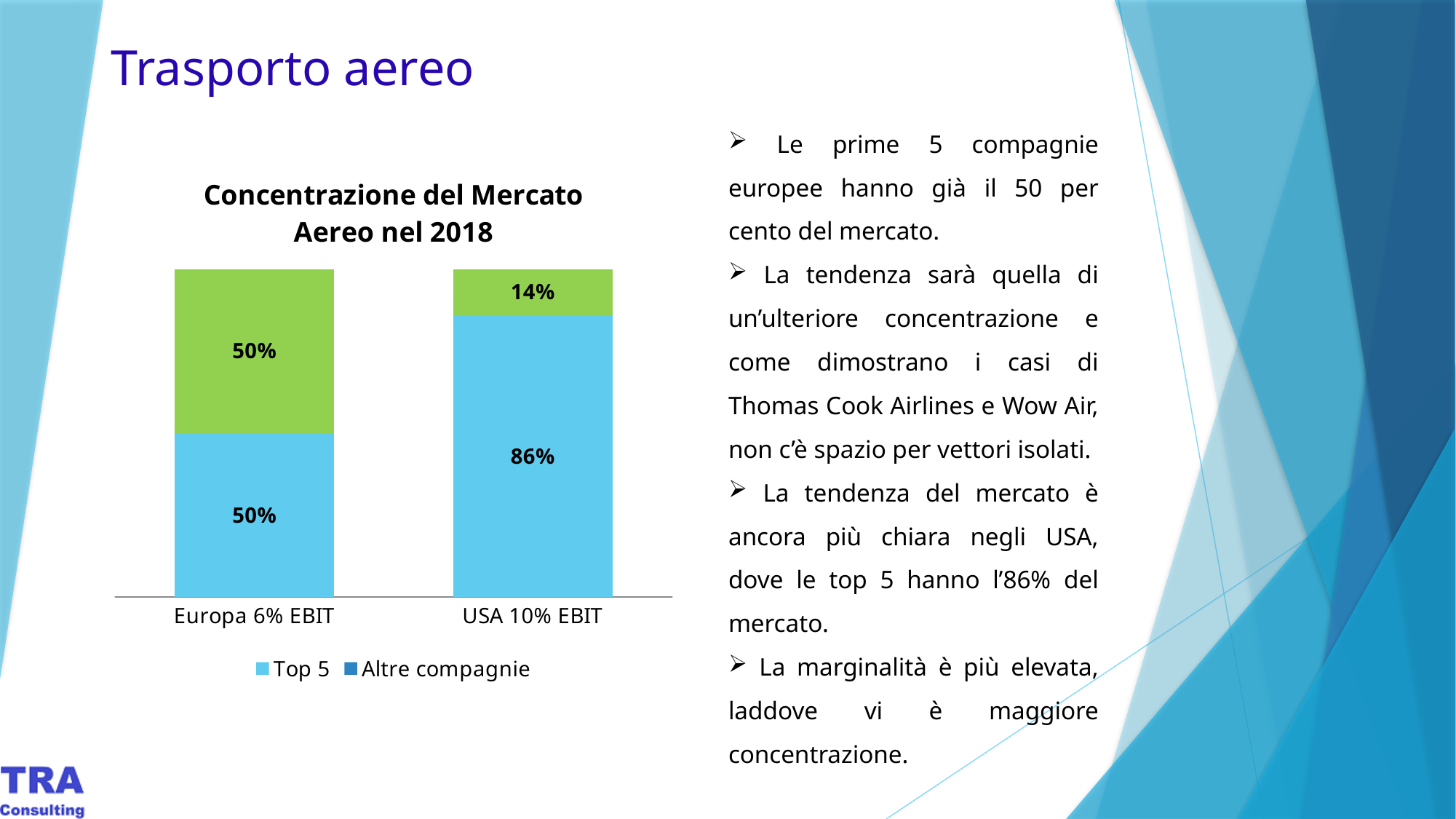
Is the Top 5 value larger for Europa 6% EBIT or USA 10% EBIT? USA 10% EBIT Which category has the highest Top 5 value? USA 10% EBIT What is the title of the chart? Concentrazione del Mercato Aereo nel 2018 What is the value for Altre compagnie in the Europa 6% EBIT bar? 50% Which category has the lowest Altre compagnie value? USA 10% EBIT What is the value for Altre compagnie in the USA 10% EBIT bar? 14% What is the difference between the Top 5 values for USA 10% EBIT and Europa 6% EBIT? 36% How many series does the legend list? 2 What kind of chart is shown on the slide? Stacked bar chart What is the value for Top 5 in the Europa 6% EBIT bar? 50% What is the value for Top 5 in the USA 10% EBIT bar? 86% How many categories are shown on the x axis? 2